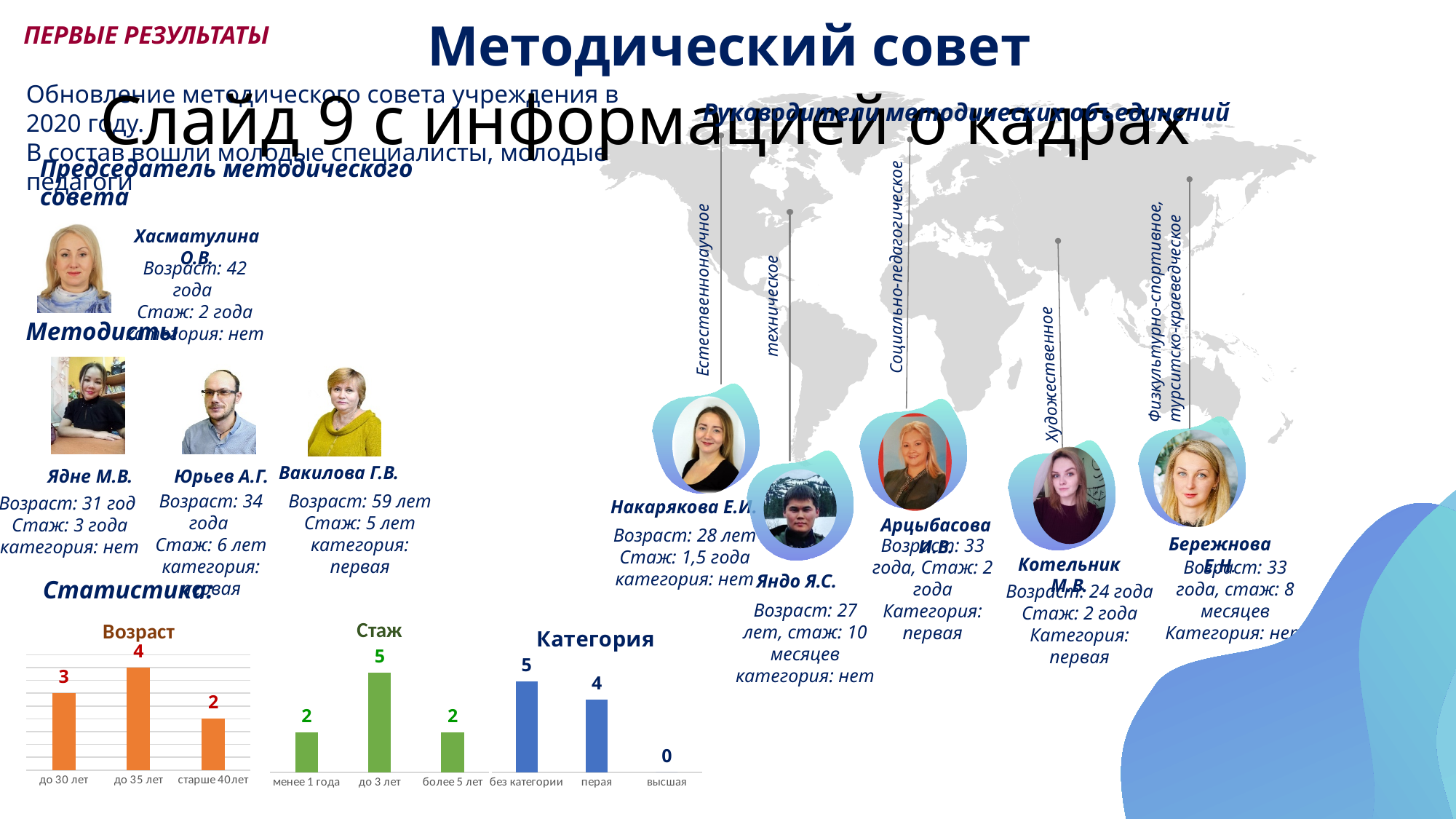
In the "Стаж" chart, what is the value for "до 3 лет"? 5 In the "Категория" chart, what is the difference between "без категории" and "перая"? 1 In the "Возраст" chart, what is the difference between "до 35 лет" and "старше 40лет"? 2 How many categories are shown in the "Стаж" chart? 3 How many bar charts are shown in the "Статистика" section of the slide? 3 In the "Возраст" chart, what is the value for "до 35 лет"? 4 In the "Возраст" chart, which category has the lowest value? старше 40лет In the "Категория" chart, which is larger: "без категории" or "перая"? без категории In the "Стаж" chart, which category has the highest value? до 3 лет What type of chart is the "Категория" chart? bar chart In the "Категория" chart, do the values rise or fall from left to right? fall In the "Категория" chart, what is the value for "высшая"? 0